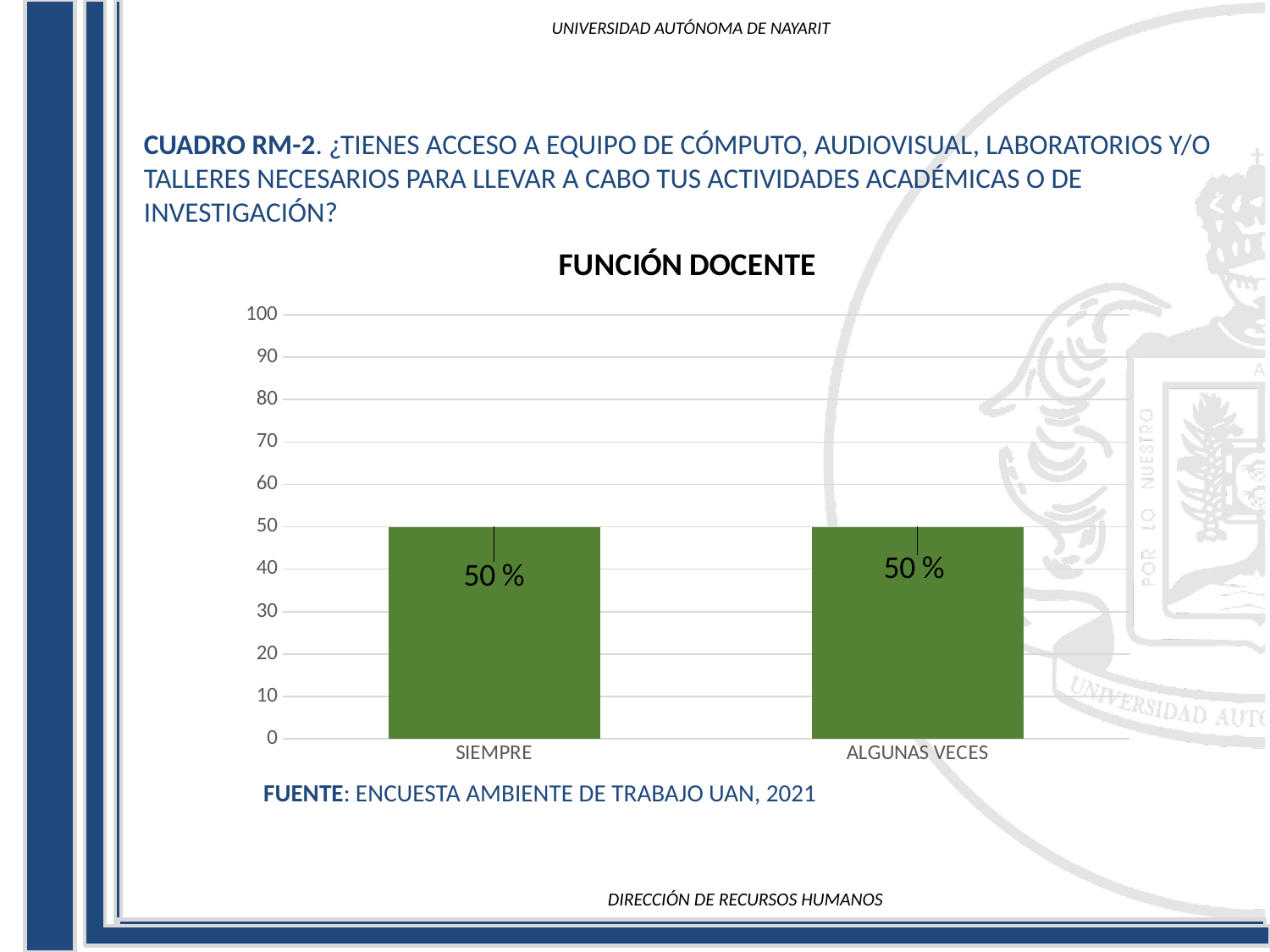
What is the value for ALGUNAS VECES? 50 % What is the title of the chart? FUNCIÓN DOCENTE How many categories are shown on the x axis? 2 Is the value for SIEMPRE greater or less than 60? less What colour are the bars in the chart? green What is the highest value shown on the y axis? 100 Is the value for ALGUNAS VECES greater or less than 40? greater What is the difference between the values for SIEMPRE and ALGUNAS VECES? 0 % What kind of chart is shown on the slide? bar chart What is the value for SIEMPRE? 50 %